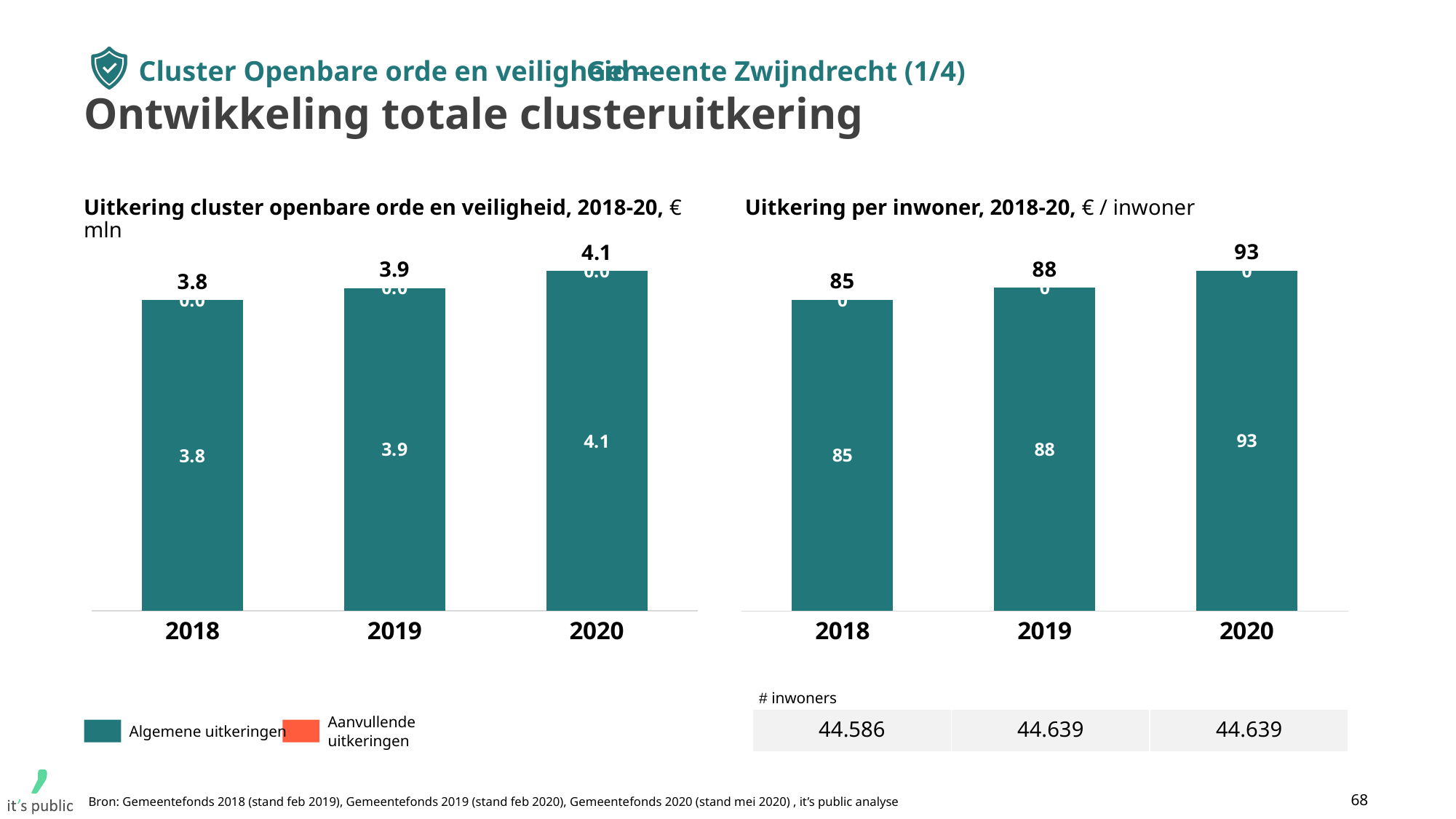
In the right chart (Uitkering per inwoner), do the values rise or fall from 2018 to 2020? Rise How many years are shown on the x axis of the left chart? 3 In the right chart (Uitkering per inwoner), which year has the highest value? 2020 How many series does the legend of the left chart list? 2 In the right chart (Uitkering per inwoner), which year has the lowest value? 2018 In the left chart (Uitkering cluster openbare orde en veiligheid), which is larger: the 2019 total or the 2020 total? 2020 In the right chart (Uitkering per inwoner), what is the difference between the 2020 and 2018 values? 8 In the right chart (Uitkering per inwoner), what is the value for 2019? 88 In the left chart (Uitkering cluster openbare orde en veiligheid), what is the total value for 2018? 3.8 What type of chart is the right chart (Uitkering per inwoner)? Bar chart In the left chart (Uitkering cluster openbare orde en veiligheid), what is the difference between the 2020 and 2019 totals? 0.2 In the left chart (Uitkering cluster openbare orde en veiligheid), what is the total value for 2020? 4.1